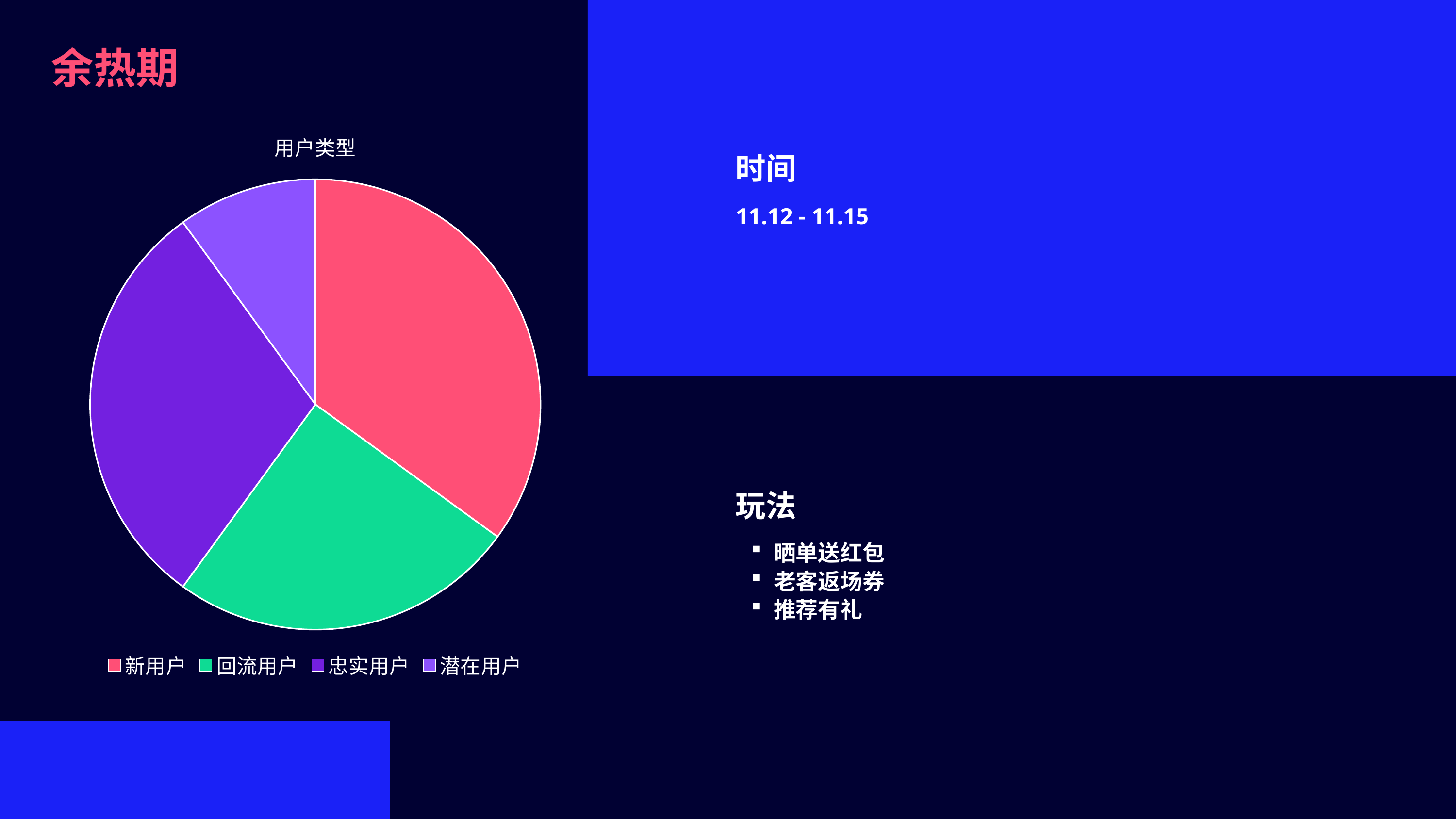
What is the title of the pie chart? 用户类型 Which user type has the largest slice in the pie chart? 新用户 Which slice is larger in the pie chart, 忠实用户 or 潜在用户? 忠实用户 Which slice is larger in the pie chart, 新用户 or 潜在用户? 新用户 How many entries does the legend of the pie chart list? 4 Which slice is larger in the pie chart, 回流用户 or 潜在用户? 回流用户 What kind of chart is shown on the slide? pie chart What colour is the 回流用户 slice in the pie chart? green Which user type has the smallest slice in the pie chart? 潜在用户 How many slices does the pie chart have? 4